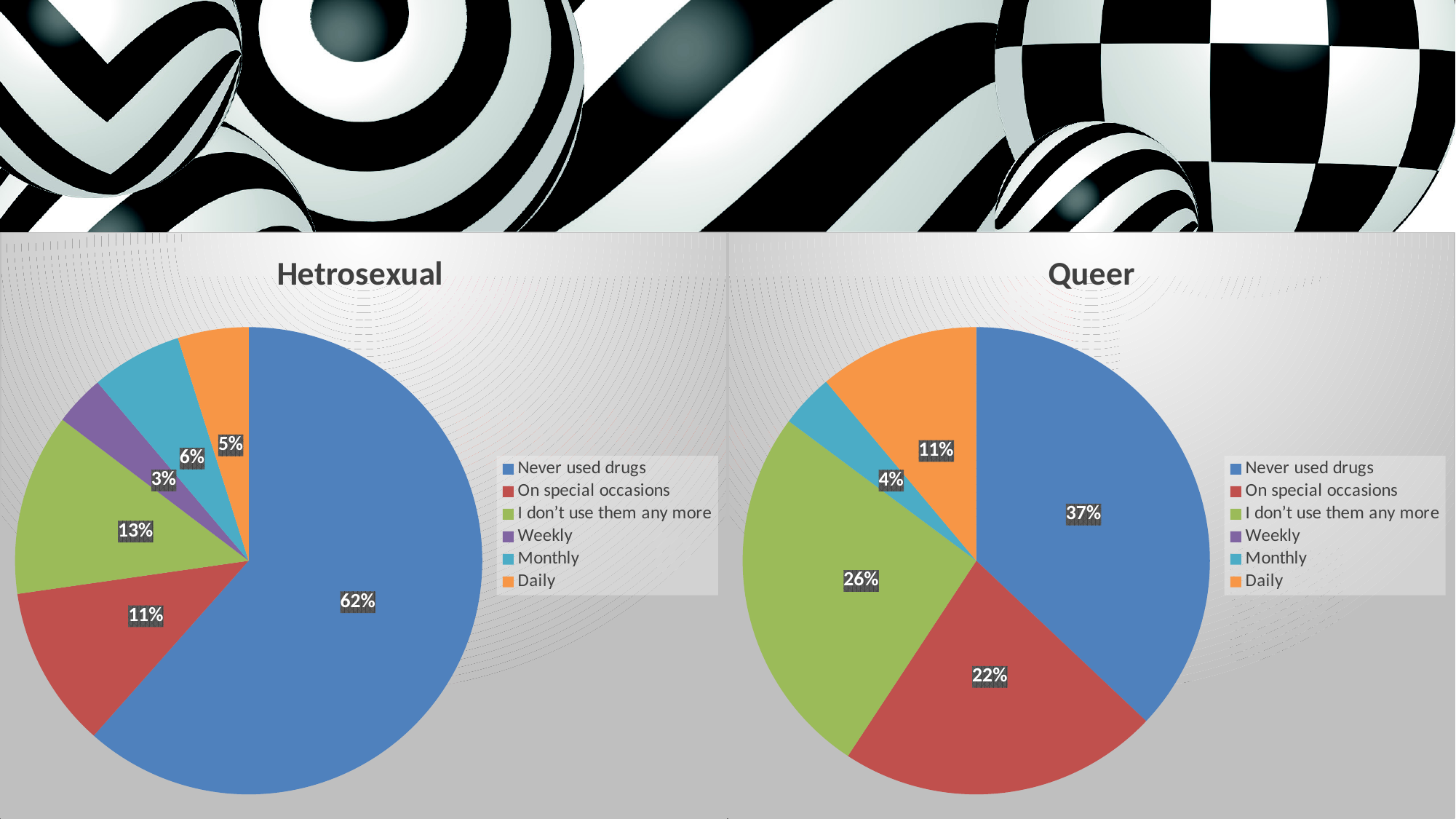
In the Queer pie chart, which is larger: the Daily slice or the Monthly slice? Daily In the Queer pie chart, which category has the largest slice? Never used drugs What kind of chart is used on this slide? Pie chart In the Hetrosexual pie chart, what is the difference between the Monthly and Daily shares? 1% In the Queer pie chart, what share is labelled for On special occasions? 22% In the Hetrosexual pie chart, which category has the largest slice? Never used drugs What is the difference between the Never used drugs share in the Hetrosexual chart and in the Queer chart? 25% In the Hetrosexual pie chart, what share is labelled for Never used drugs? 62% In the Hetrosexual pie chart, what share is labelled for Weekly? 3% In the Hetrosexual pie chart, which category has the smallest labelled slice? Weekly How many categories does the legend of the Queer chart list? 6 In the Queer pie chart, what share is labelled for I don't use them any more? 26%